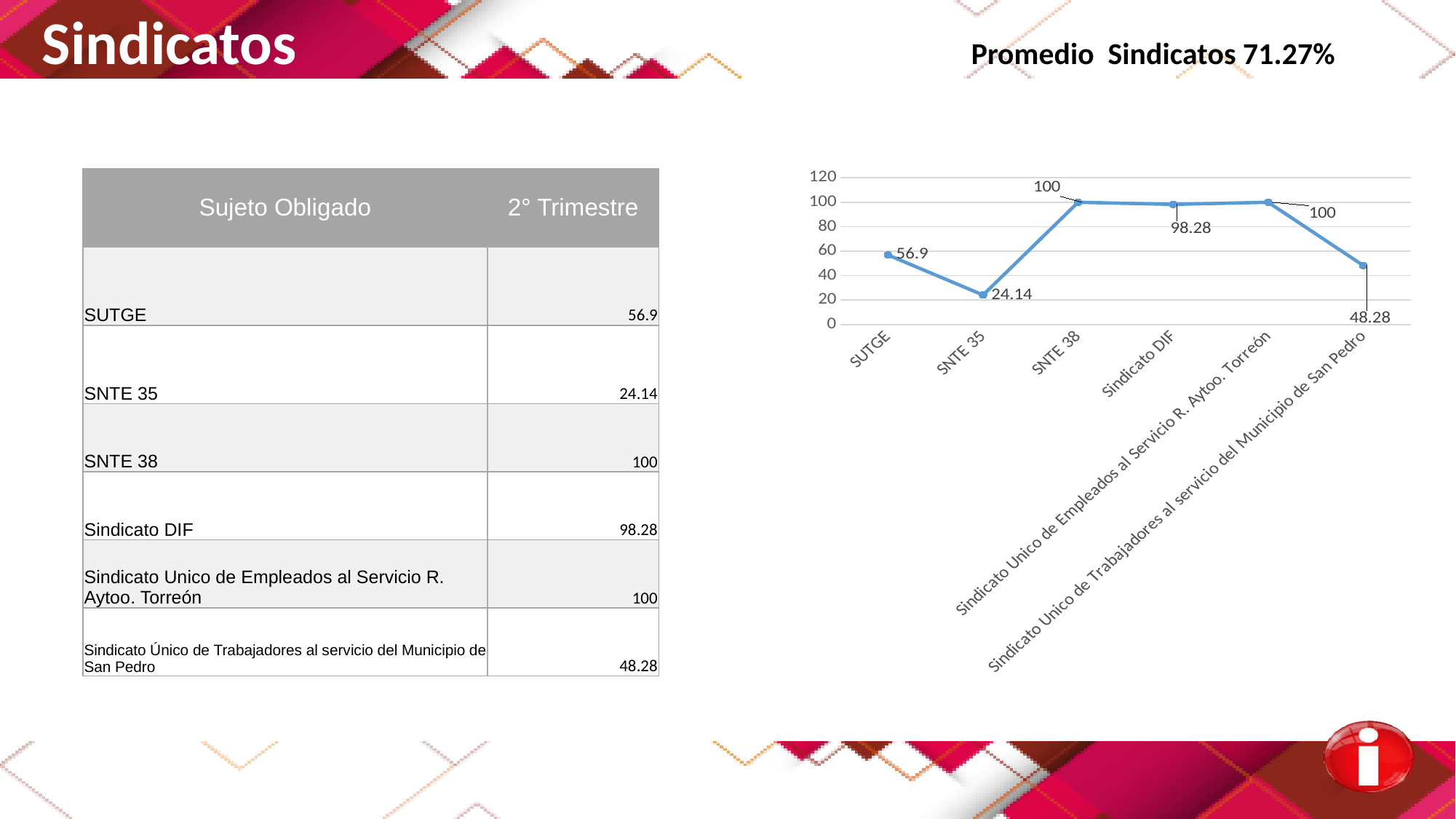
How many categories are plotted on the x axis of the chart? 6 Which category has the lowest value in the chart? SNTE 35 What type of chart is shown on the slide? line chart What is the difference between the values for SUTGE and SNTE 35? 32.76 Does the line rise or fall from Sindicato Unico de Empleados al Servicio R. Aytoo. Torreón to Sindicato Unico de Trabajadores al servicio del Municipio de San Pedro? fall Which is larger, the value for SNTE 38 or the value for Sindicato DIF? SNTE 38 What is the value for SNTE 35 in the chart? 24.14 What is the highest tick value shown on the y axis of the chart? 120 What is the value for Sindicato DIF in the chart? 98.28 Is the value for SNTE 35 greater or less than 40? less What is the value for SUTGE in the chart? 56.9 What is the value for Sindicato Unico de Trabajadores al servicio del Municipio de San Pedro in the chart? 48.28